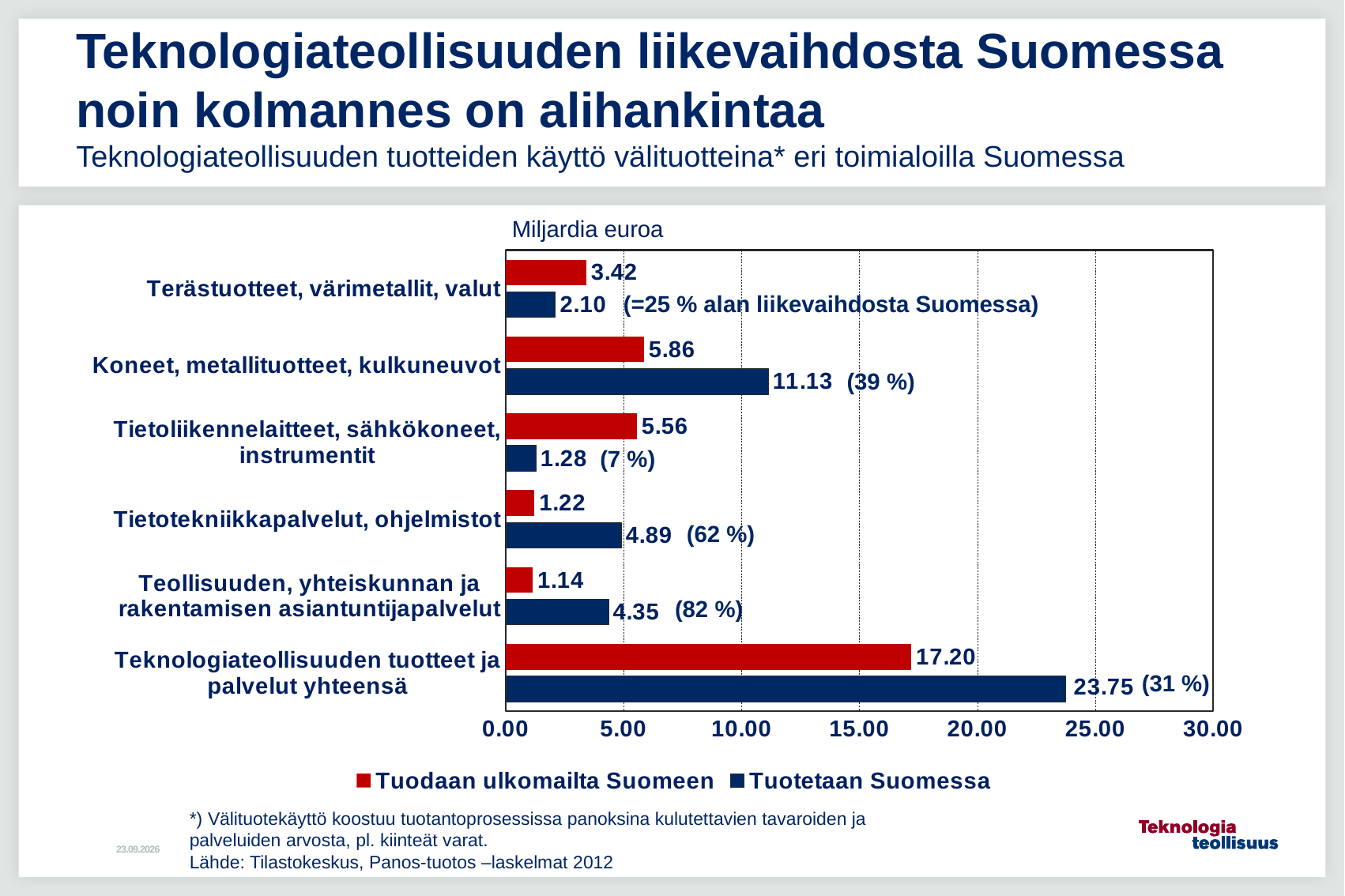
What is the value of "Tuotetaan Suomessa" for "Tietotekniikkapalvelut, ohjelmistot"? 4.89 What kind of chart is shown on the slide? bar chart Excluding the total row, which category has the highest value for "Tuotetaan Suomessa"? Koneet, metallituotteet, kulkuneuvot How many categories are shown on the chart? 6 Is the value of "Tuodaan ulkomailta Suomeen" for "Teknologiateollisuuden tuotteet ja palvelut yhteensä" greater or less than 15.00? greater What is the difference between "Tuotetaan Suomessa" and "Tuodaan ulkomailta Suomeen" for "Koneet, metallituotteet, kulkuneuvot"? 5.27 What is the value of "Tuotetaan Suomessa" for "Teknologiateollisuuden tuotteet ja palvelut yhteensä"? 23.75 How many series does the legend list? 2 Which category has the lowest value for "Tuodaan ulkomailta Suomeen"? Teollisuuden, yhteiskunnan ja rakentamisen asiantuntijapalvelut What is the value of "Tuodaan ulkomailta Suomeen" for "Koneet, metallituotteet, kulkuneuvot"? 5.86 For "Tietoliikennelaitteet, sähkökoneet, instrumentit", which is larger: "Tuodaan ulkomailta Suomeen" or "Tuotetaan Suomessa"? Tuodaan ulkomailta Suomeen What unit is shown above the chart? Miljardia euroa